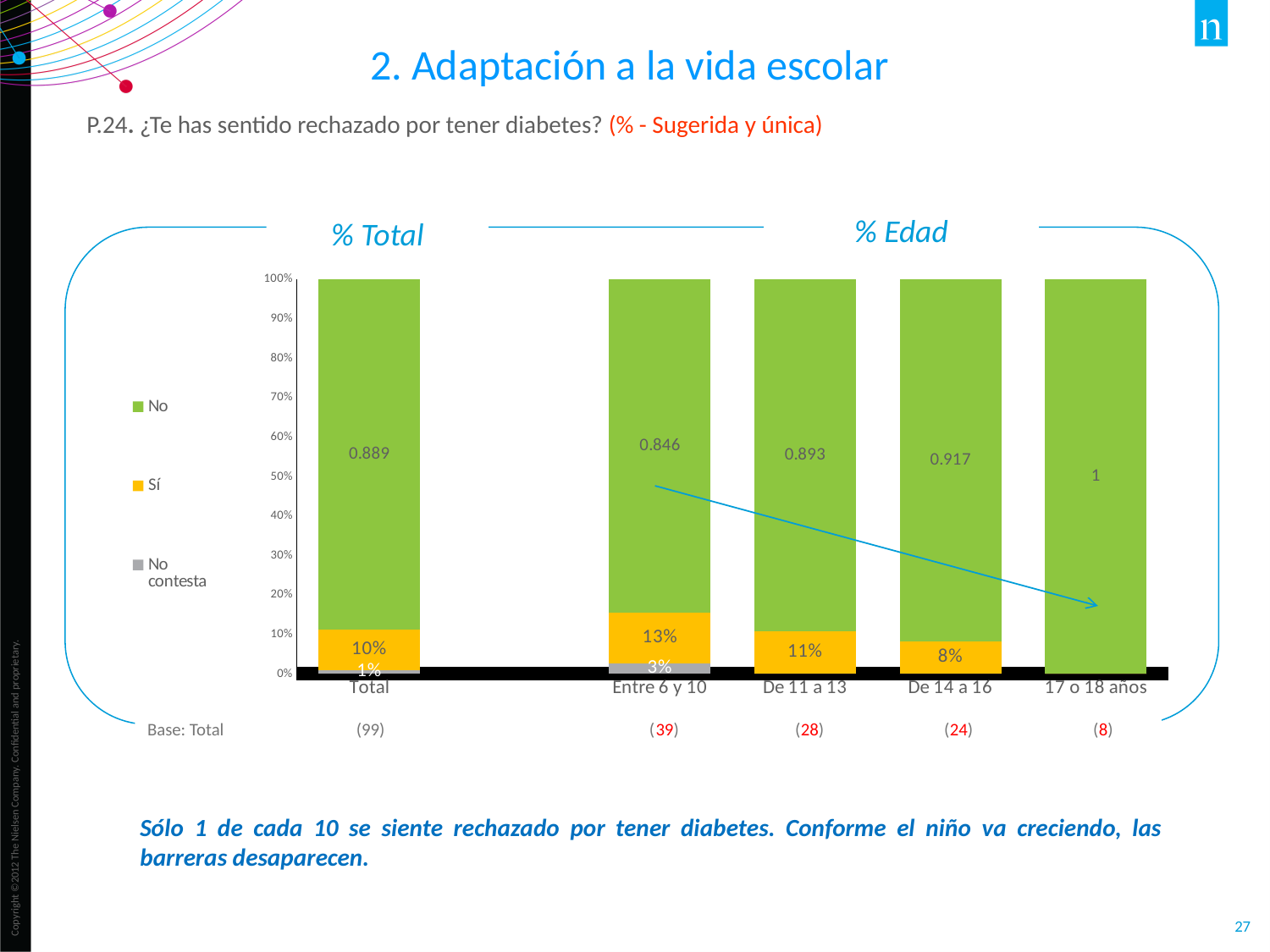
What is the value of the 'No' segment for the Total bar? 0.889 What is the 'Sí' value for the 'Entre 6 y 10' age group? 13% How many series does the legend list? 3 Which is larger, the 'Sí' value for 'De 11 a 13' or for 'De 14 a 16'? De 11 a 13 What is the difference between the 'Sí' value for 'Entre 6 y 10' and for 'De 14 a 16'? 5 percentage points Across the age groups from 'Entre 6 y 10' to '17 o 18 años', does the 'No' value rise or fall? Rise What kind of chart is shown on the slide? Stacked bar chart What is the 'No' value for the '17 o 18 años' age group? 1 Which category has the highest 'No' value? 17 o 18 años Which age group has the highest 'Sí' value? Entre 6 y 10 How many bars (categories) are shown in the chart? 5 What is the 'No contesta' value for the 'Entre 6 y 10' age group? 3%